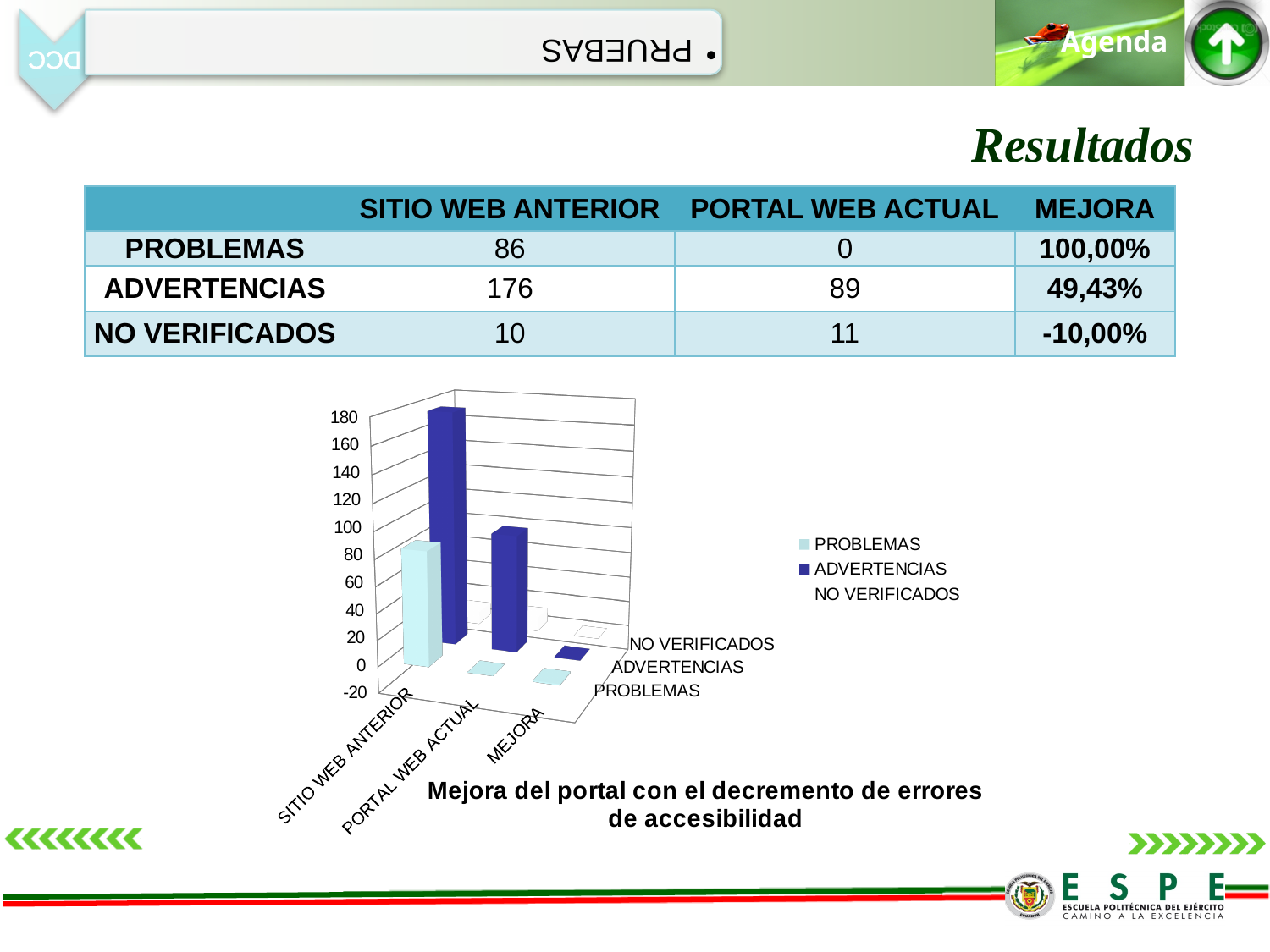
What kind of chart is shown on the slide? bar chart Which is larger, the ADVERTENCIAS value for SITIO WEB ANTERIOR or for PORTAL WEB ACTUAL? SITIO WEB ANTERIOR What is the ADVERTENCIAS value for SITIO WEB ANTERIOR? 176 Is the PROBLEMAS value for SITIO WEB ANTERIOR greater or less than 60? greater What is the title of the chart? Mejora del portal con el decremento de errores de accesibilidad How many categories are shown along the x axis of the chart? 3 Which series has the tallest bar for SITIO WEB ANTERIOR? ADVERTENCIAS Is the ADVERTENCIAS value for SITIO WEB ANTERIOR greater or less than 160? greater What is the difference between the ADVERTENCIAS values for SITIO WEB ANTERIOR and PORTAL WEB ACTUAL? 87 Which series is listed second in the chart legend? ADVERTENCIAS Is the ADVERTENCIAS value for PORTAL WEB ACTUAL greater or less than 120? less How many series does the chart legend list? 3